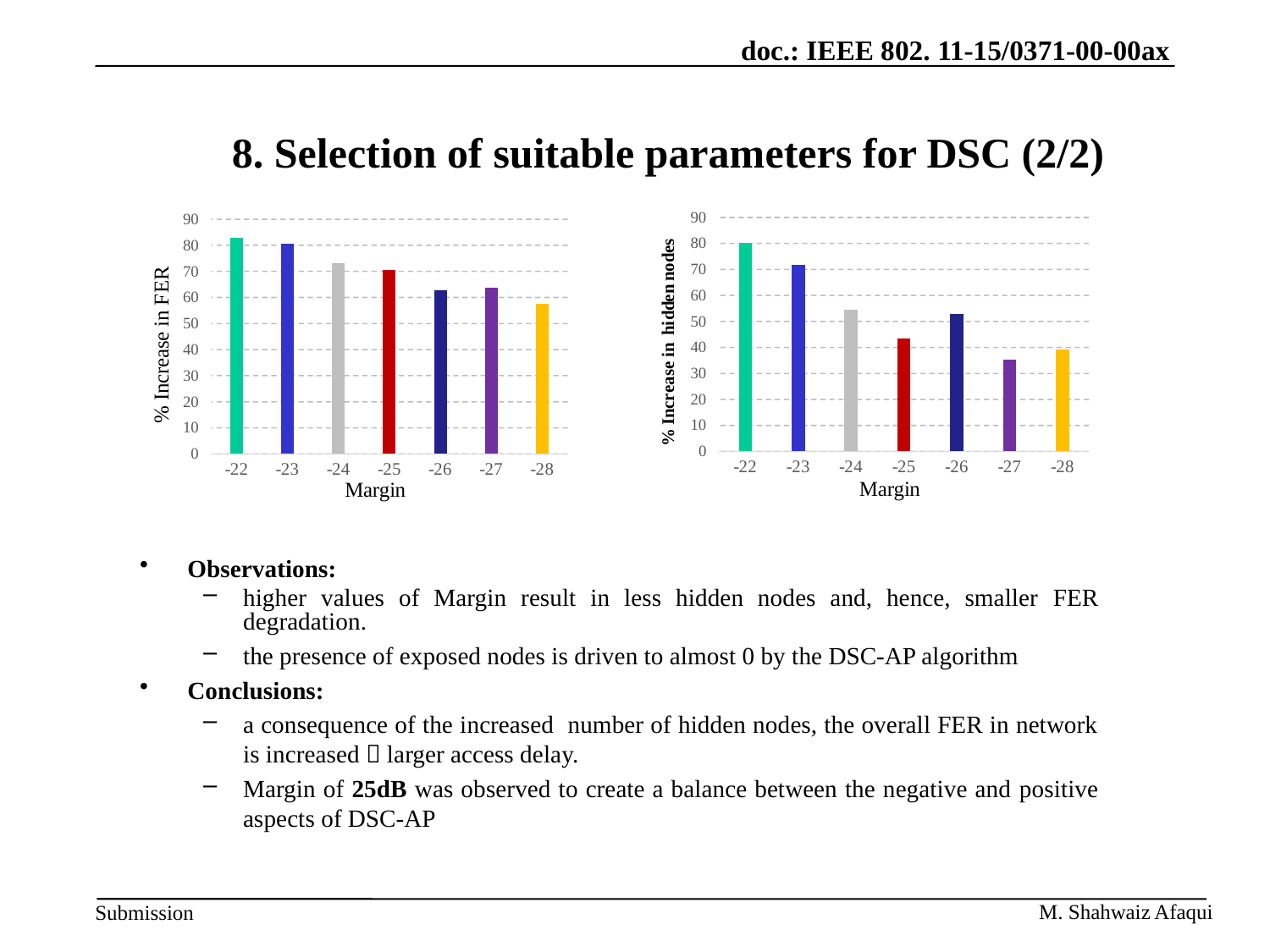
In the right chart, which is larger: the value for Margin -24 or the value for Margin -25? -24 What kind of chart is the left chart on the slide? bar chart In the right chart, is the value for Margin -23 greater or less than 70? greater In the right chart, is the value for Margin -25 greater or less than 50? less In the left chart, is the value for Margin -22 greater or less than 80? greater What is the y-axis label of the left chart? % Increase in FER How many Margin categories are shown on the x axis of the right chart? 7 In the right chart, which Margin has the lowest % Increase in hidden nodes? -27 In the left chart, which Margin has the lowest % Increase in FER? -28 In the right chart, do the values generally rise or fall as Margin goes from -22 to -28? fall In the right chart, which Margin has the highest % Increase in hidden nodes? -22